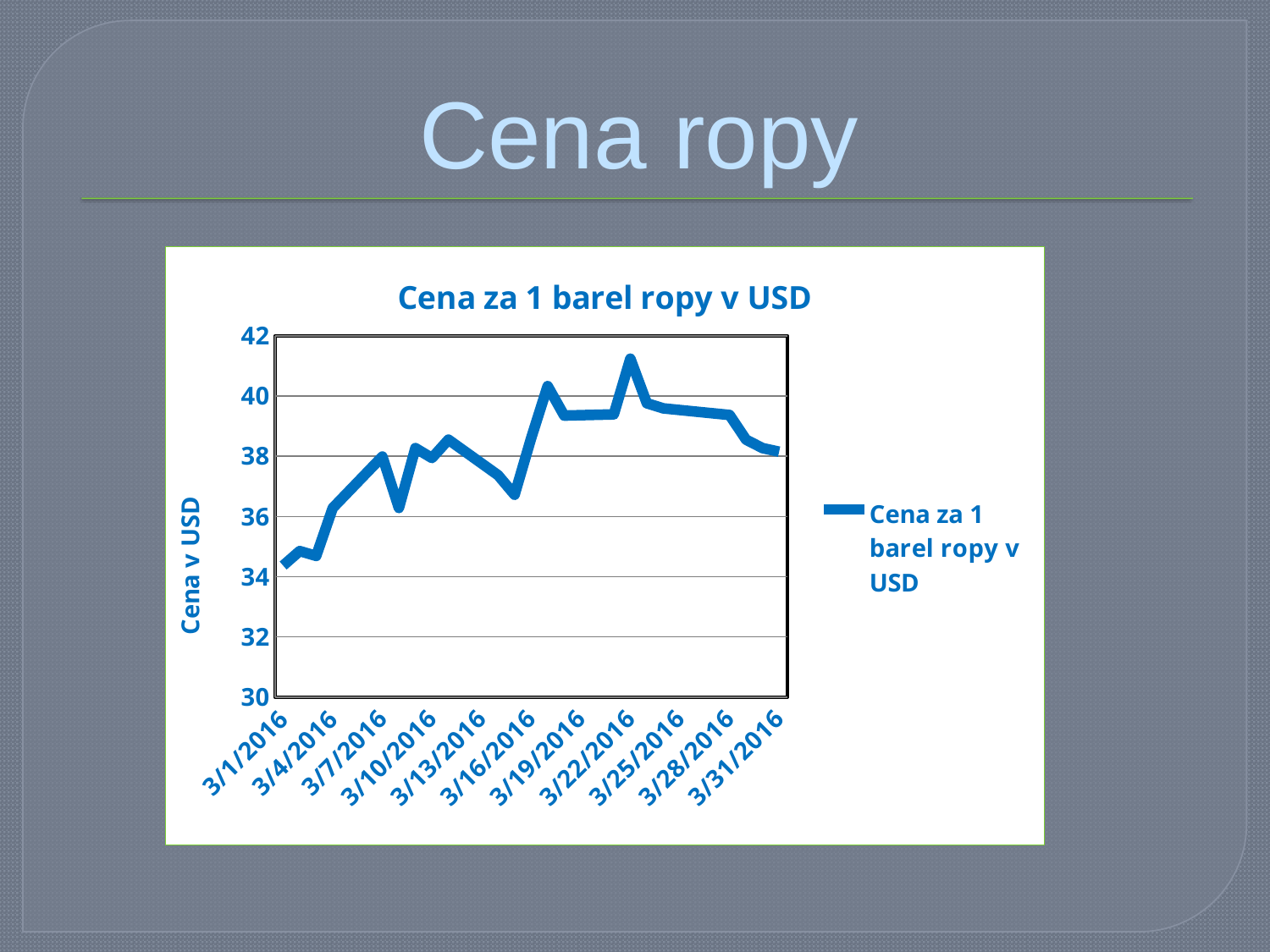
How many date labels are shown on the x axis? 11 On which labelled date does the price reach its highest value? 3/22/2016 How many series does the legend list? 1 What is the label on the vertical axis of the chart? Cena v USD Is the value for 3/1/2016 greater or less than 36? less Overall, does the price rise or fall from 3/1/2016 to 3/31/2016? rise Is the value for 3/22/2016 greater or less than 40? greater On which labelled date is the price at its lowest value? 3/1/2016 Is the value for 3/31/2016 greater or less than 36? greater What is the title of the chart? Cena za 1 barel ropy v USD What kind of chart is shown on the slide? line chart